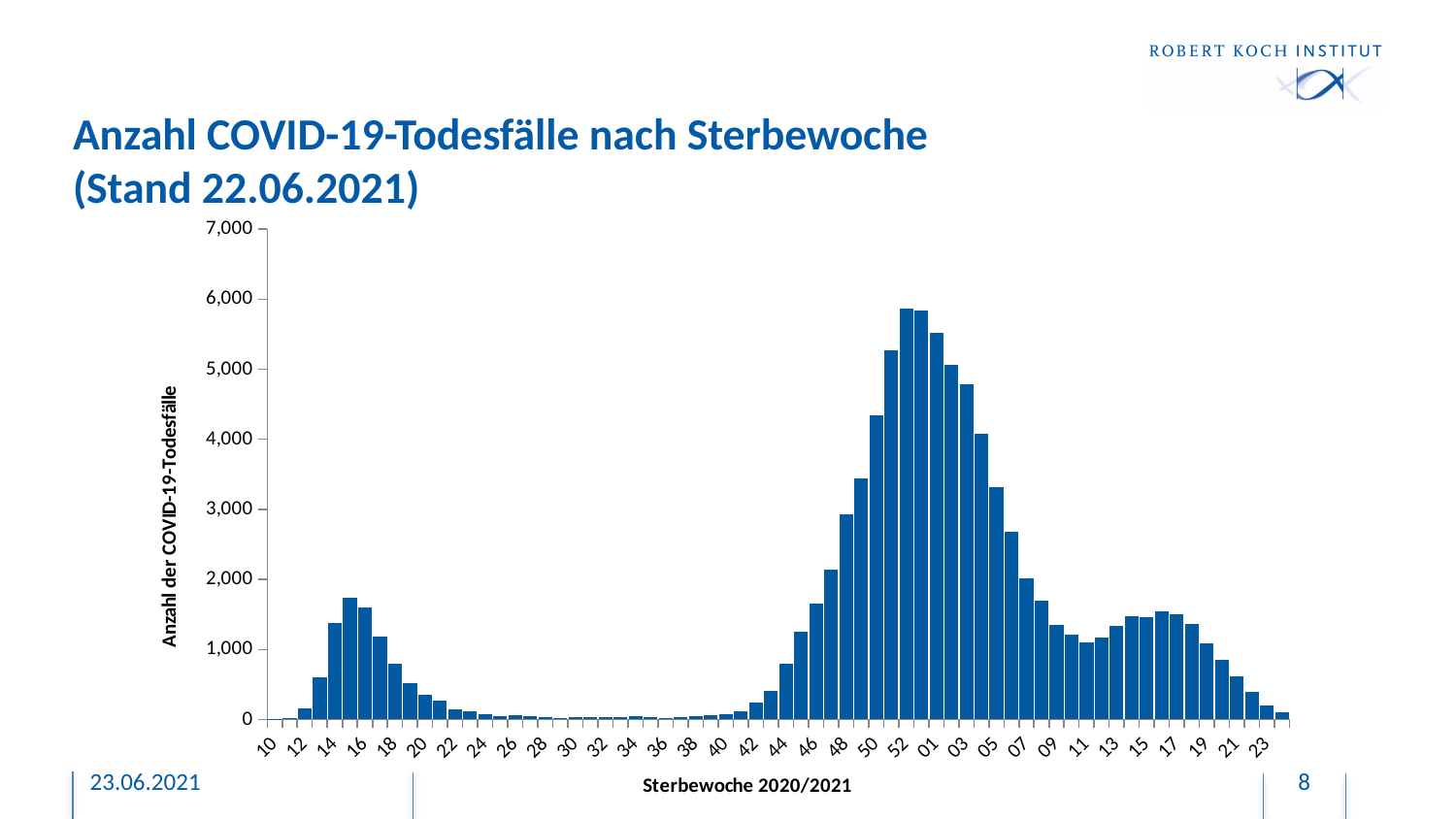
Is the value for week 30 greater or less than 1,000? less Is the value for week 48 greater or less than 2,000? greater Which is larger, the value for week 52 or the value for week 16? week 52 What is the label of the x axis of the chart? Sterbewoche 2020/2021 What kind of chart is shown on the slide? bar chart Is the value for week 14 greater or less than 1,000? greater What is the title of the chart on the slide? Anzahl COVID-19-Todesfälle nach Sterbewoche (Stand 22.06.2021) Which is larger, the value for week 03 or the value for week 05? week 03 Do the values rise or fall from week 52 to week 05? fall